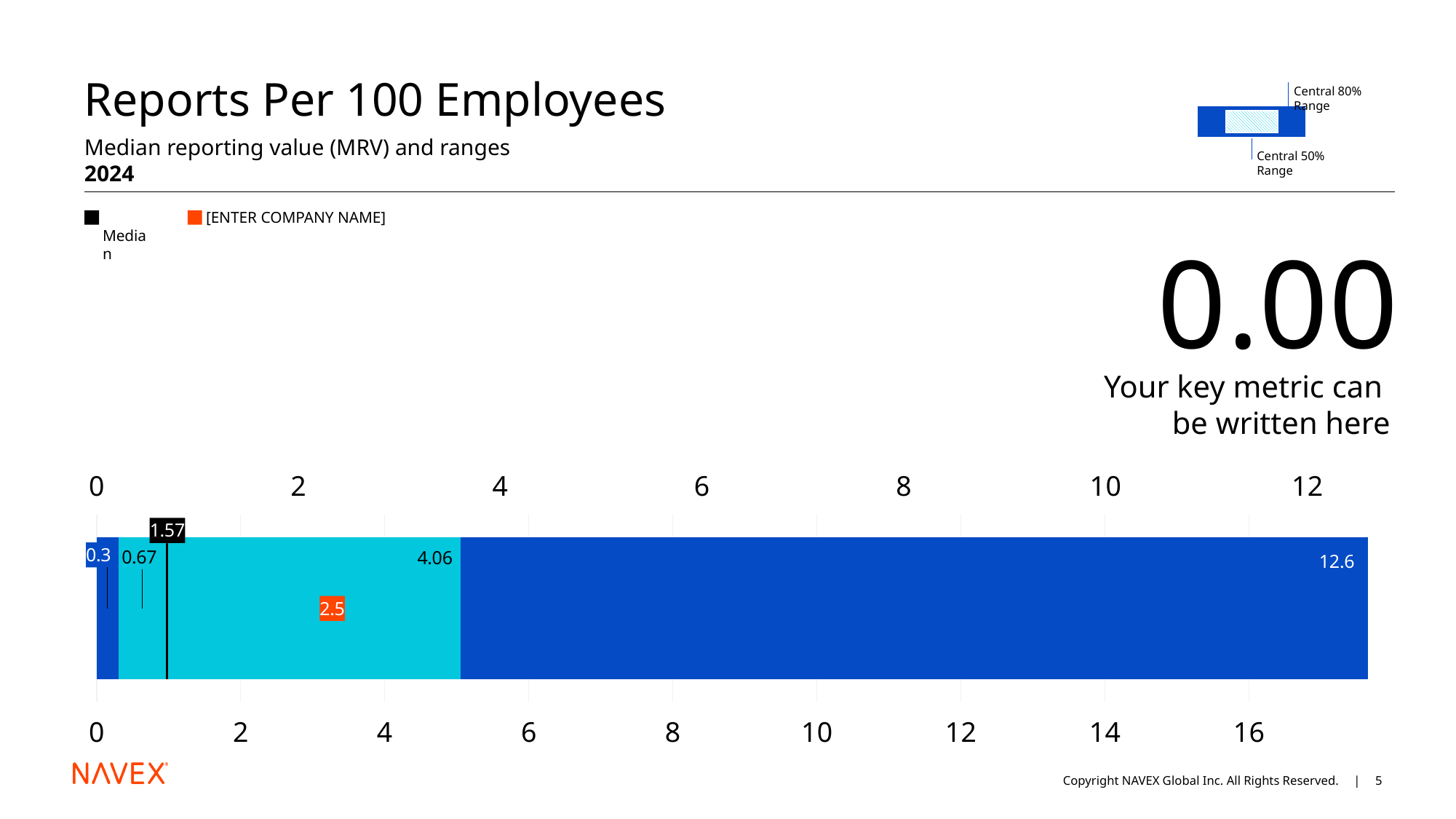
How many numeric values are labelled on the chart? 6 What is the lower end of the central 50% range labelled on the chart? 0.67 What is the upper end of the central 50% range labelled on the chart? 4.06 What is the title of the chart? Reports Per 100 Employees What is the median value marked on the chart? 1.57 How many entries does the legend list? 2 What is the difference between the upper (4.06) and lower (0.67) ends of the central 50% range? 3.39 What value is marked for [ENTER COMPANY NAME] on the chart? 2.5 What is the lowest value labelled on the chart? 0.3 By how much does the [ENTER COMPANY NAME] value exceed the median? 0.93 What is the highest value labelled on the chart? 12.6 Which is larger, the [ENTER COMPANY NAME] value or the median? [ENTER COMPANY NAME] (2.5)